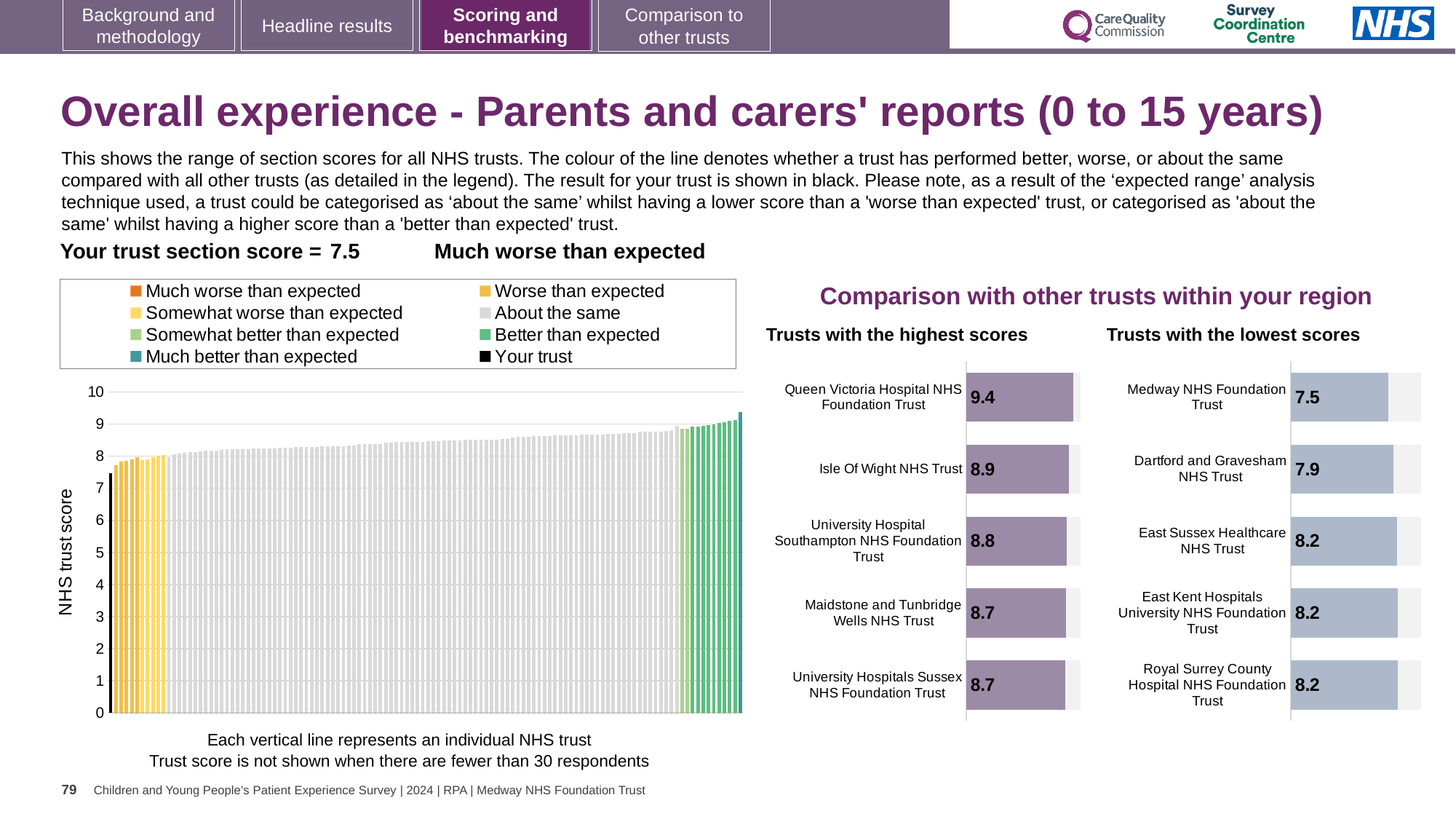
In the 'Trusts with the highest scores' chart, which has the larger score: University Hospital Southampton NHS Foundation Trust or Maidstone and Tunbridge Wells NHS Trust? University Hospital Southampton NHS Foundation Trust In the 'Trusts with the lowest scores' chart, which trust has the lowest score? Medway NHS Foundation Trust In the 'Trusts with the highest scores' chart, what is the score for Queen Victoria Hospital NHS Foundation Trust? 9.4 In the 'Trusts with the lowest scores' chart, what is the difference between the scores of Dartford and Gravesham NHS Trust and Medway NHS Foundation Trust? 0.4 In the 'Trusts with the lowest scores' chart, what is the score for Medway NHS Foundation Trust? 7.5 What kind of chart is the left-hand chart showing all NHS trust scores? Bar chart How many trusts are shown in the 'Trusts with the lowest scores' chart? 5 In the 'Trusts with the highest scores' chart, what is the score for Isle Of Wight NHS Trust? 8.9 In the 'Trusts with the highest scores' chart, what is the difference between the scores of Queen Victoria Hospital NHS Foundation Trust and Isle Of Wight NHS Trust? 0.5 In the 'Trusts with the lowest scores' chart, what is the score for Dartford and Gravesham NHS Trust? 7.9 How many entries does the legend of the left-hand chart list? 8 In the 'Trusts with the highest scores' chart, which trust has the highest score? Queen Victoria Hospital NHS Foundation Trust